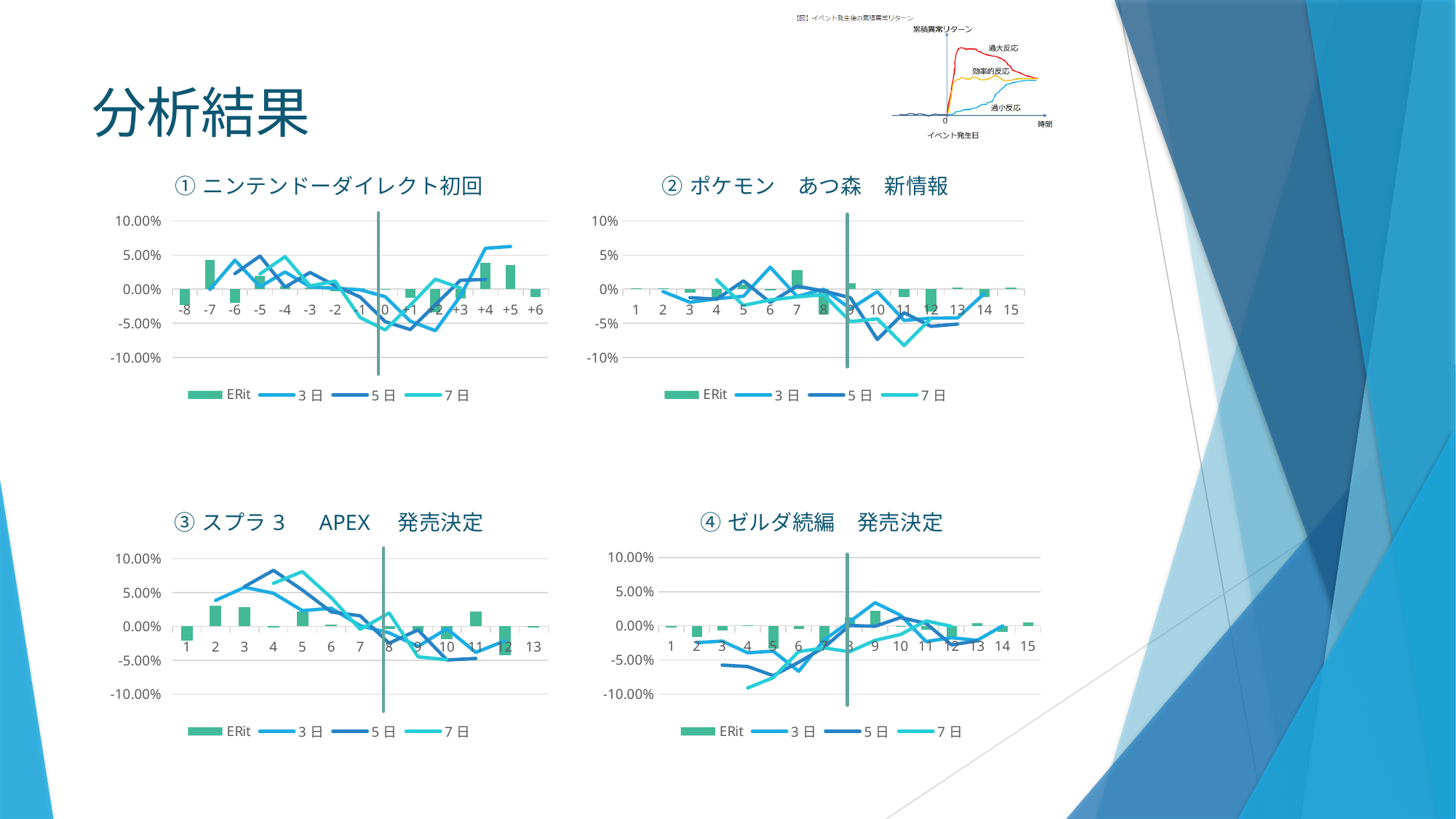
What kind of chart is the chart titled ① ニンテンドーダイレクト初回? Combined bar and line chart In the chart titled ② ポケモン あつ森 新情報, which category has the highest ERit bar? 7 How many series does the legend of the chart titled ① ニンテンドーダイレクト初回 list? 4 In the chart titled ③ スプラ 3 APEX 発売決定, which category has the lowest ERit bar? 12 What are the legend entries of the chart titled ② ポケモン あつ森 新情報? ERit, 3 日, 5 日, 7 日 In the chart titled ③ スプラ 3 APEX 発売決定, is the 5 日 value at 4 greater or less than 5.00%? greater What is the title of the chart in the top-left of the slide? ① ニンテンドーダイレクト初回 In the chart titled ① ニンテンドーダイレクト初回, is the ERit value at +4 greater or less than 0.00%? greater In the chart titled ③ スプラ 3 APEX 発売決定, is the ERit value at 12 greater or less than 0.00%? less How many categories are on the x axis of the chart titled ④ ゼルダ続編 発売決定? 15 How many categories are on the x axis of the chart titled ③ スプラ 3 APEX 発売決定? 13